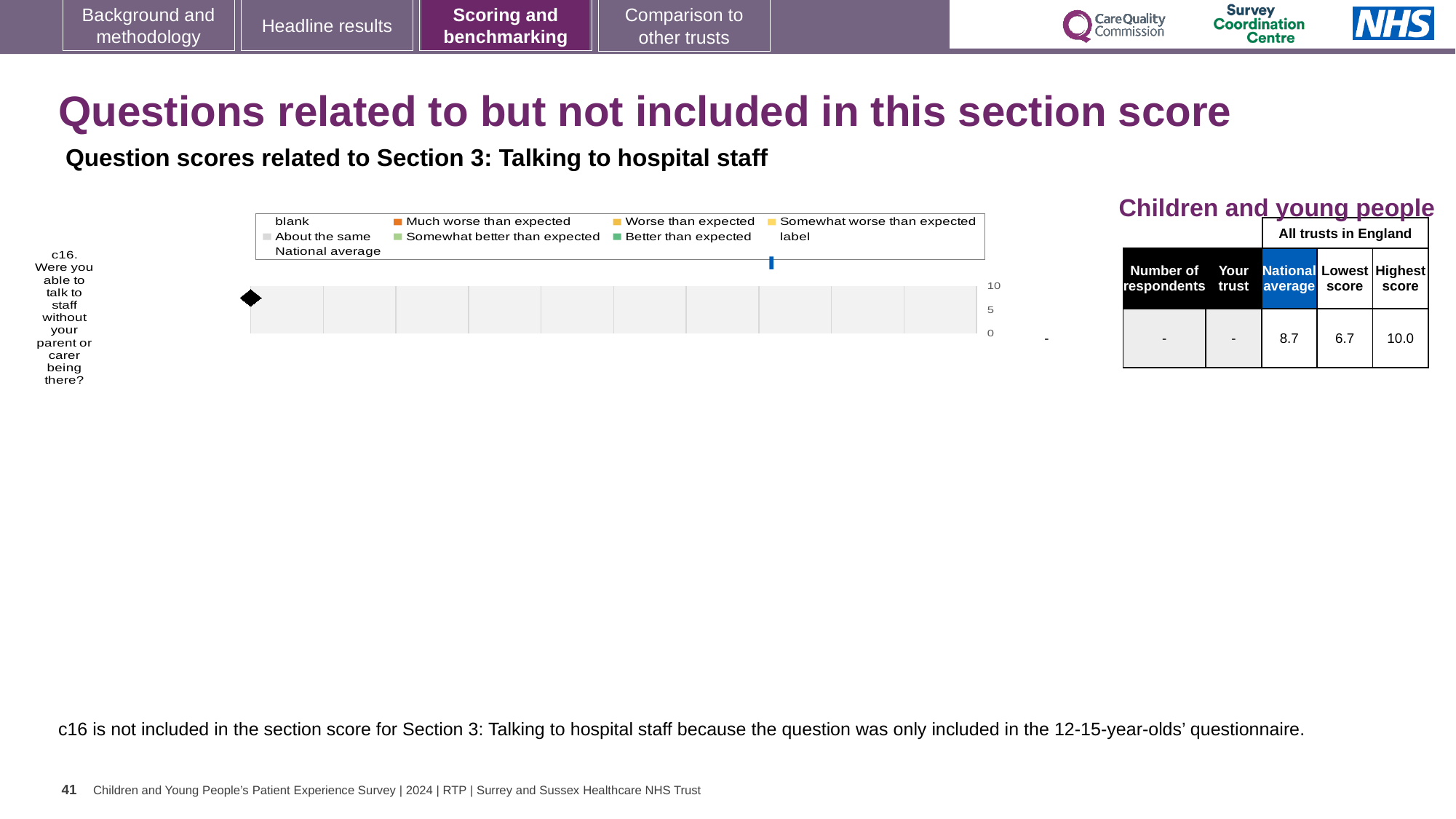
In the Children and young people table, what is the Lowest score for c16? 6.7 What is the full text of the question label on the chart's category axis? c16. Were you able to talk to staff without your parent or carer being there? What kind of chart is shown for question c16? bar chart In the Children and young people table, what is the difference between the National average and the Lowest score for c16? 2.0 In the Children and young people table, what is the Highest score for c16? 10.0 In the Children and young people table, which is larger for c16: the National average or the Lowest score? National average In the Children and young people table, what is shown for Your trust for c16? - In the Children and young people table, what is the difference between the Highest score and the Lowest score for c16? 3.3 How many entries does the chart legend list? 9 In the Children and young people table, what is the National average score for c16? 8.7 How many question categories are plotted on the chart? 1 What is the highest tick value shown on the chart's value axis? 10